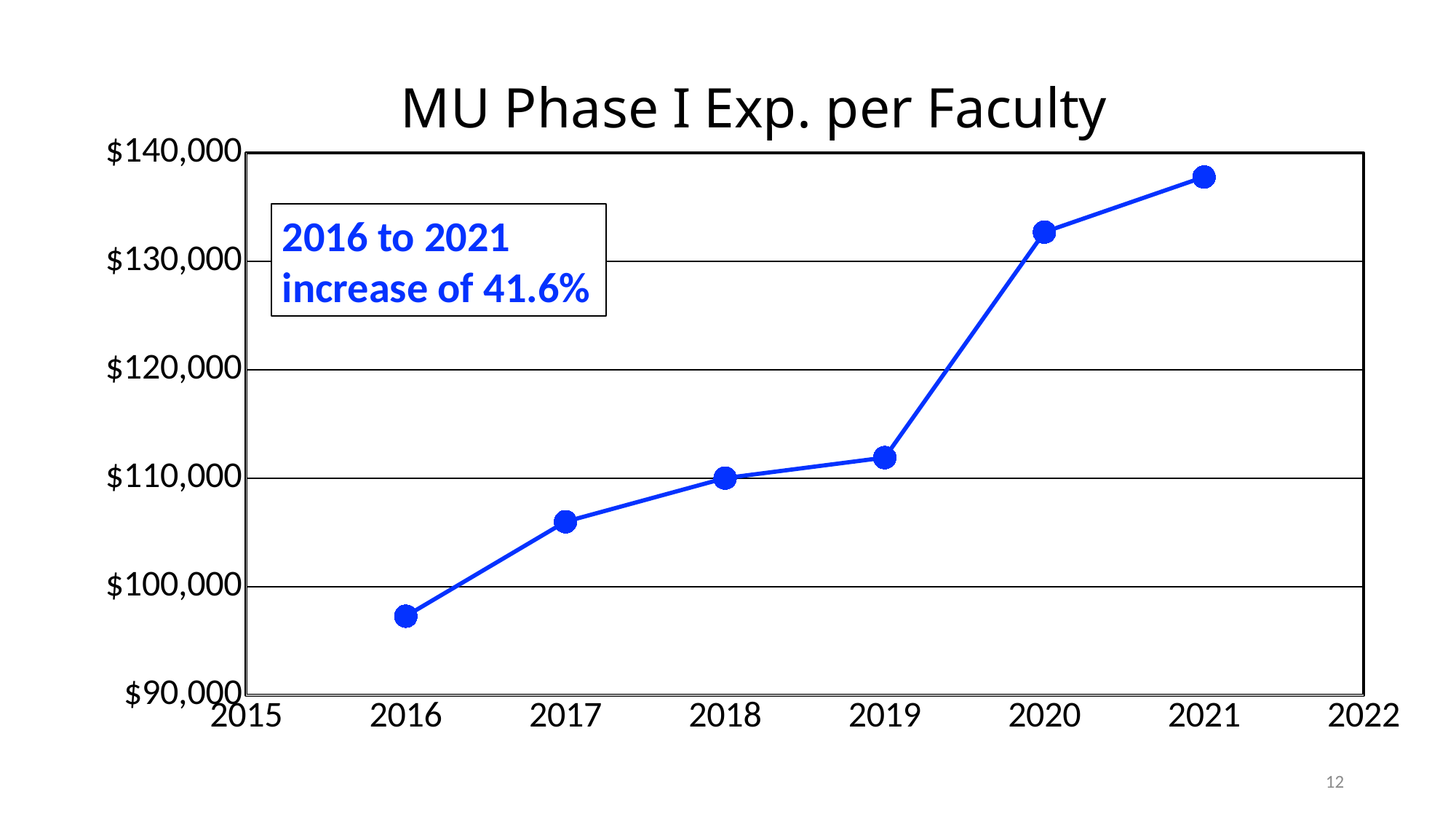
Which year has the larger value, 2019 or 2020? 2020 According to the text box on the chart, what is the percentage increase from 2016 to 2021? 41.6% What kind of chart is shown on the slide? line chart Do the values rise or fall from 2016 to 2021? rise Is the value for 2019 greater or less than $120,000? less Which year has the highest expenditure per faculty? 2021 Is the value for 2017 greater or less than $100,000? greater Is the value for 2016 greater or less than $100,000? less Which year has the lowest expenditure per faculty? 2016 What is the title of the chart? MU Phase I Exp. per Faculty How many data points are plotted on the line? 6